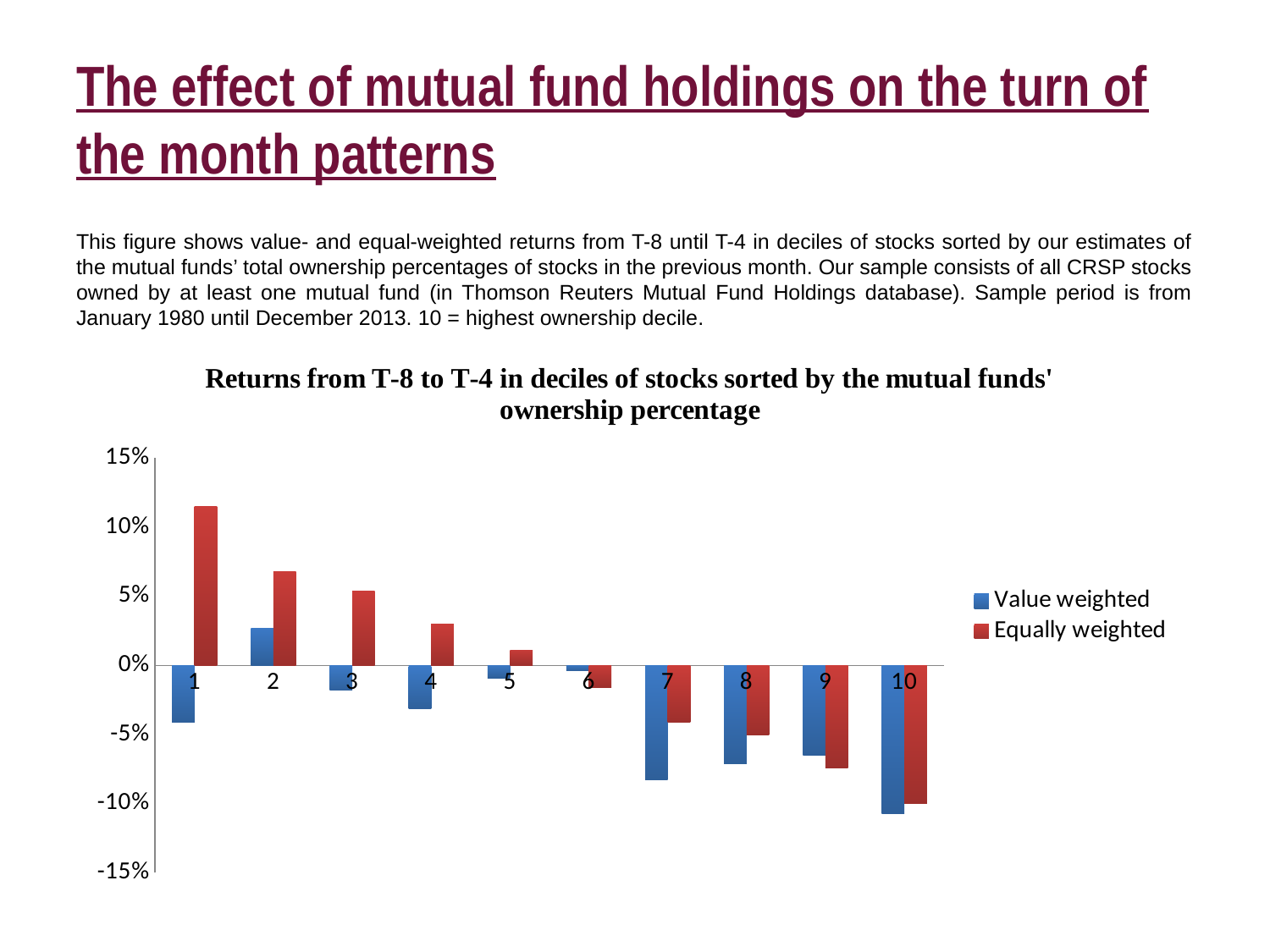
Is the Value weighted return for decile 10 greater or less than -10%? less What kind of chart is shown on the slide? Bar chart What are the two series named in the legend? Value weighted and Equally weighted Is the Equally weighted return for decile 1 greater or less than 10%? greater Which decile has the highest Value weighted return? 2 For decile 1, which series has the larger return, Value weighted or Equally weighted? Equally weighted Which decile has the lowest Equally weighted return? 10 Which decile has the lowest Value weighted return? 10 How many series does the legend list? 2 Do the Equally weighted returns generally rise or fall from decile 1 to decile 10? Fall How many deciles are shown along the x axis? 10 Which decile has the highest Equally weighted return? 1